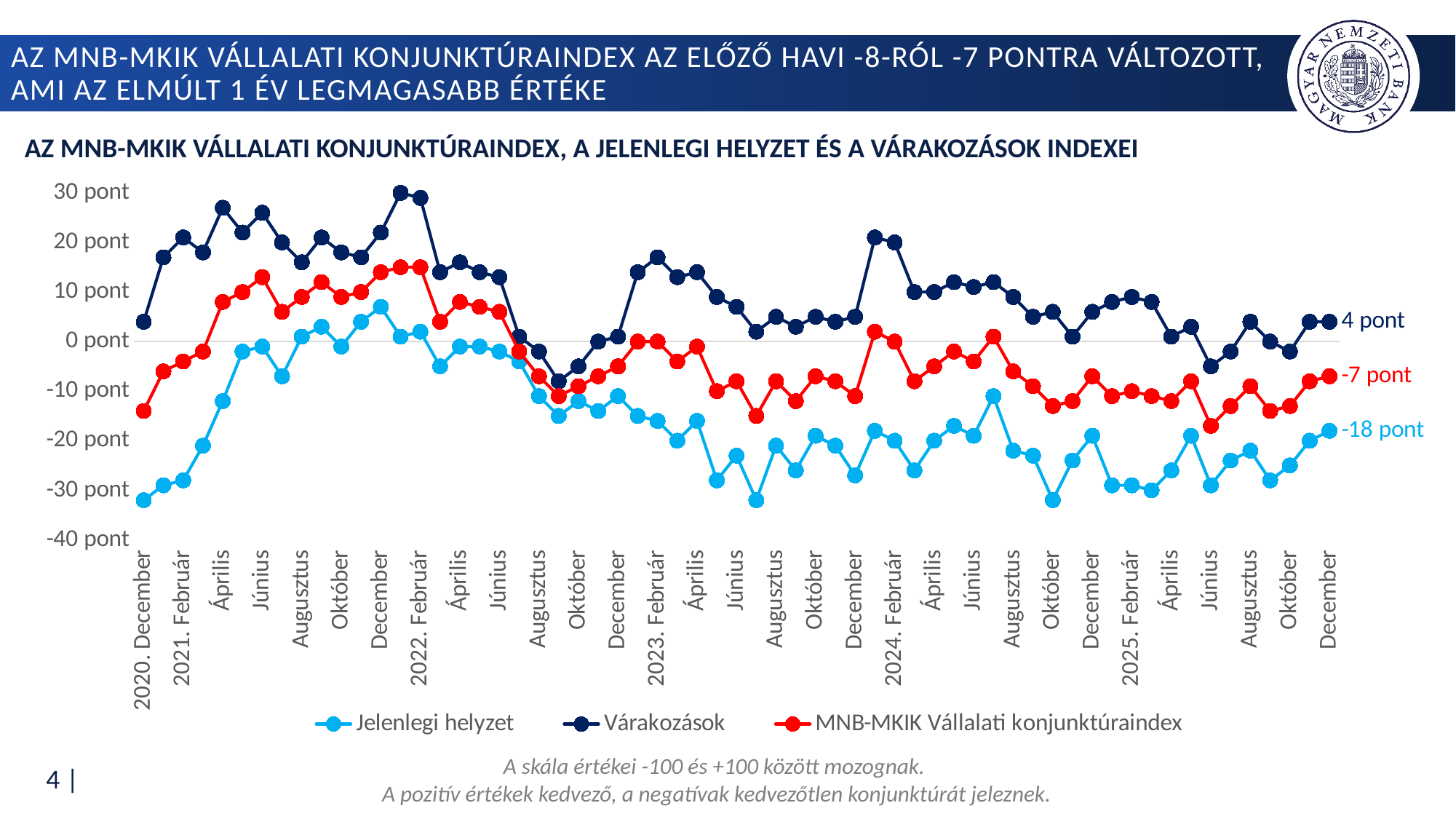
How many series does the legend list? 3 Is the value of Jelenlegi helyzet in 2020. December greater or less than -30 pont? less What is the value of the Várakozások series at the last point (December 2025)? 4 pont What is the difference between the final labelled values of Várakozások (4 pont) and Jelenlegi helyzet (-18 pont)? 22 pont Which series has the lowest value at the last point (December 2025)? Jelenlegi helyzet What kind of chart is shown on the slide? Line chart What is the difference between the final labelled values of the MNB-MKIK Vállalati konjunktúraindex (-7 pont) and Jelenlegi helyzet (-18 pont)? 11 pont At the last point (December 2025), which series has the higher value: Várakozások or Jelenlegi helyzet? Várakozások Which colour is used for the Jelenlegi helyzet series? Light blue What is the value of the Jelenlegi helyzet series at the last point (December 2025)? -18 pont What is the value of the MNB-MKIK Vállalati konjunktúraindex series at the last point (December 2025)? -7 pont Is the value of Várakozások in 2022. Február greater or less than 20 pont? greater